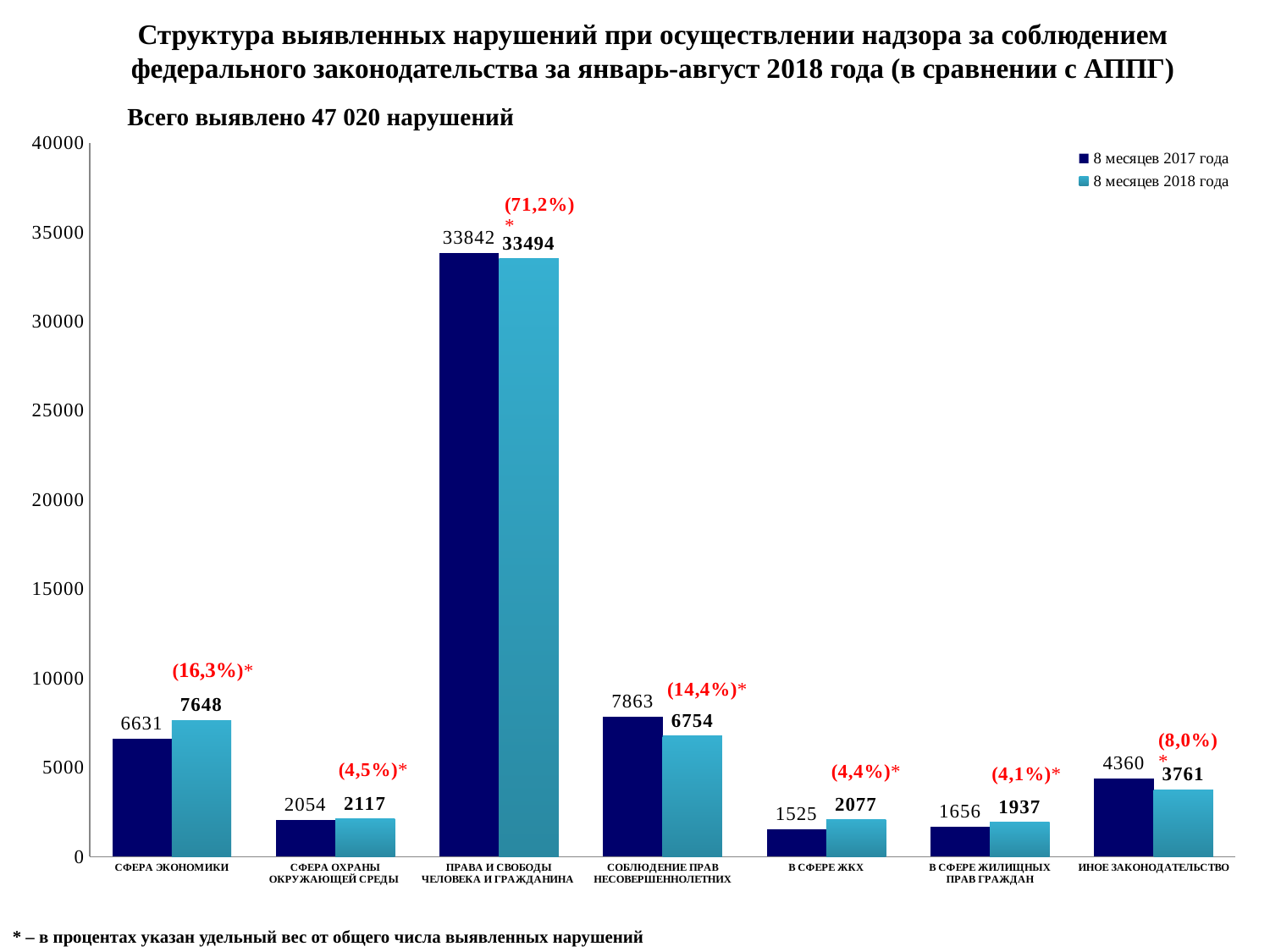
Which category has the lowest value in the "8 месяцев 2017 года" series? В сфере ЖКХ What is the value for "Сфера экономики" in the "8 месяцев 2018 года" series? 7648 What total number of violations is stated in the subtitle above the chart? 47 020 What percentage share is shown in red above the bars for "Сфера охраны окружающей среды"? (4,5%)* What is the difference between the 2017 and 2018 values for "Права и свободы человека и гражданина"? 348 What type of chart is shown on the slide? bar chart How many series does the legend list? 2 What is the value for "Соблюдение прав несовершеннолетних" in the "8 месяцев 2017 года" series? 7863 What is the value for "В сфере ЖКХ" in the "8 месяцев 2018 года" series? 2077 For "Иное законодательство", which is larger: the "8 месяцев 2017 года" value or the "8 месяцев 2018 года" value? 8 месяцев 2017 года How many categories are shown on the x axis? 7 Which category has the highest value in the "8 месяцев 2018 года" series? Права и свободы человека и гражданина